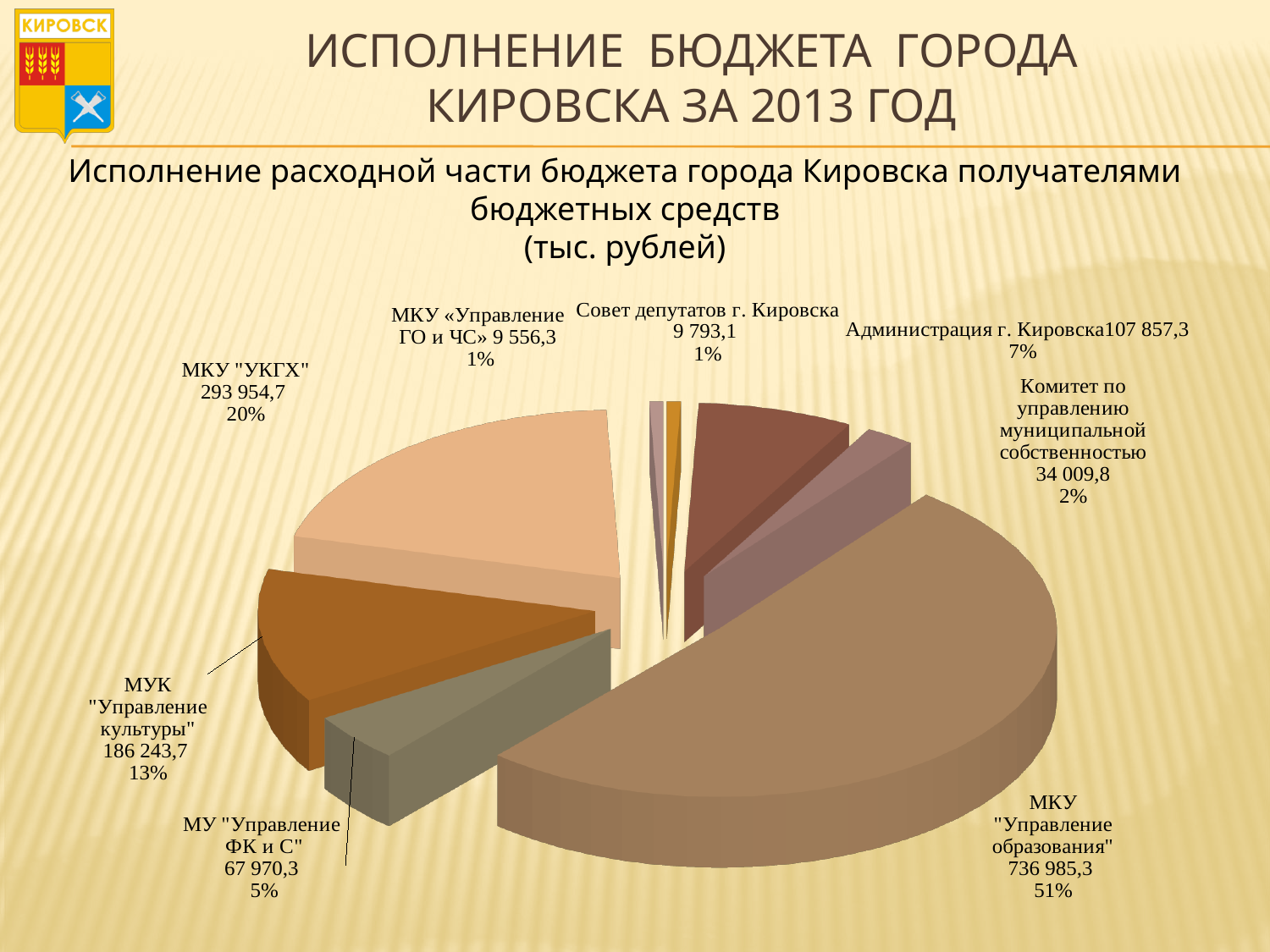
What is the value for Комитет по управлению муниципальной собственностью? 34 009,8 What is the difference between the values for МКУ "УКГХ" and МУК "Управление культуры"? 107 711,0 Which is larger: the value for Администрация г. Кировска or the value for МУ "Управление ФК и С"? Администрация г. Кировска What share of the pie does МУК "Управление культуры" represent? 13% Which recipient has the largest share of the budget expenditure? МКУ "Управление образования" What is the value for МКУ "Управление образования"? 736 985,3 What is the value for МКУ "УКГХ"? 293 954,7 What type of chart is shown on the slide? pie chart What share of the pie does МКУ "Управление образования" represent? 51% In what units are the values in the chart given, according to the chart title? тыс. рублей How many slices does the pie chart have? 8 Which recipient has the smallest value in the pie chart? МКУ «Управление ГО и ЧС»